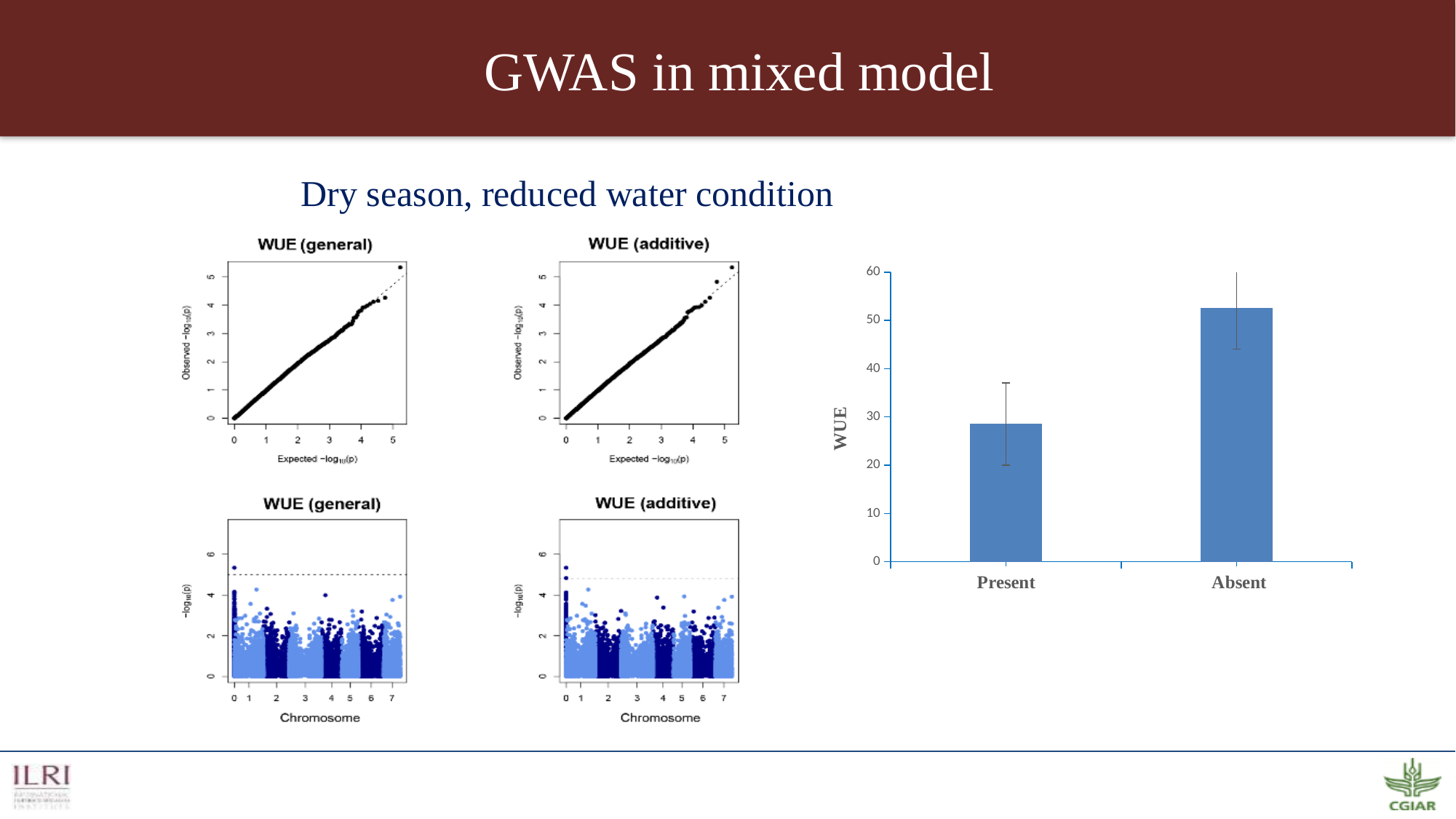
What kind of chart is the chart on the right of the slide with the categories Present and Absent? bar chart In the bar chart on the right of the slide, which category has the higher WUE value? Absent In the bar chart on the right of the slide, is the value for Present greater or less than 20? greater In the bar chart on the right of the slide, is the value for Absent greater or less than 60? less What is the title of the top-right plot among the four black-and-white/blue plots on the left side of the slide? WUE (additive) What is the label on the horizontal axis of the two plots in the bottom-left of the slide? Chromosome How many categories are shown in the bar chart on the right of the slide? 2 What is the label on the vertical axis of the bar chart on the right of the slide? WUE In the bar chart on the right of the slide, is the bar for Absent larger or smaller than the bar for Present? larger In the bar chart on the right of the slide, is the value for Present greater or less than 30? less In the bar chart on the right of the slide, which category has the lower WUE value? Present